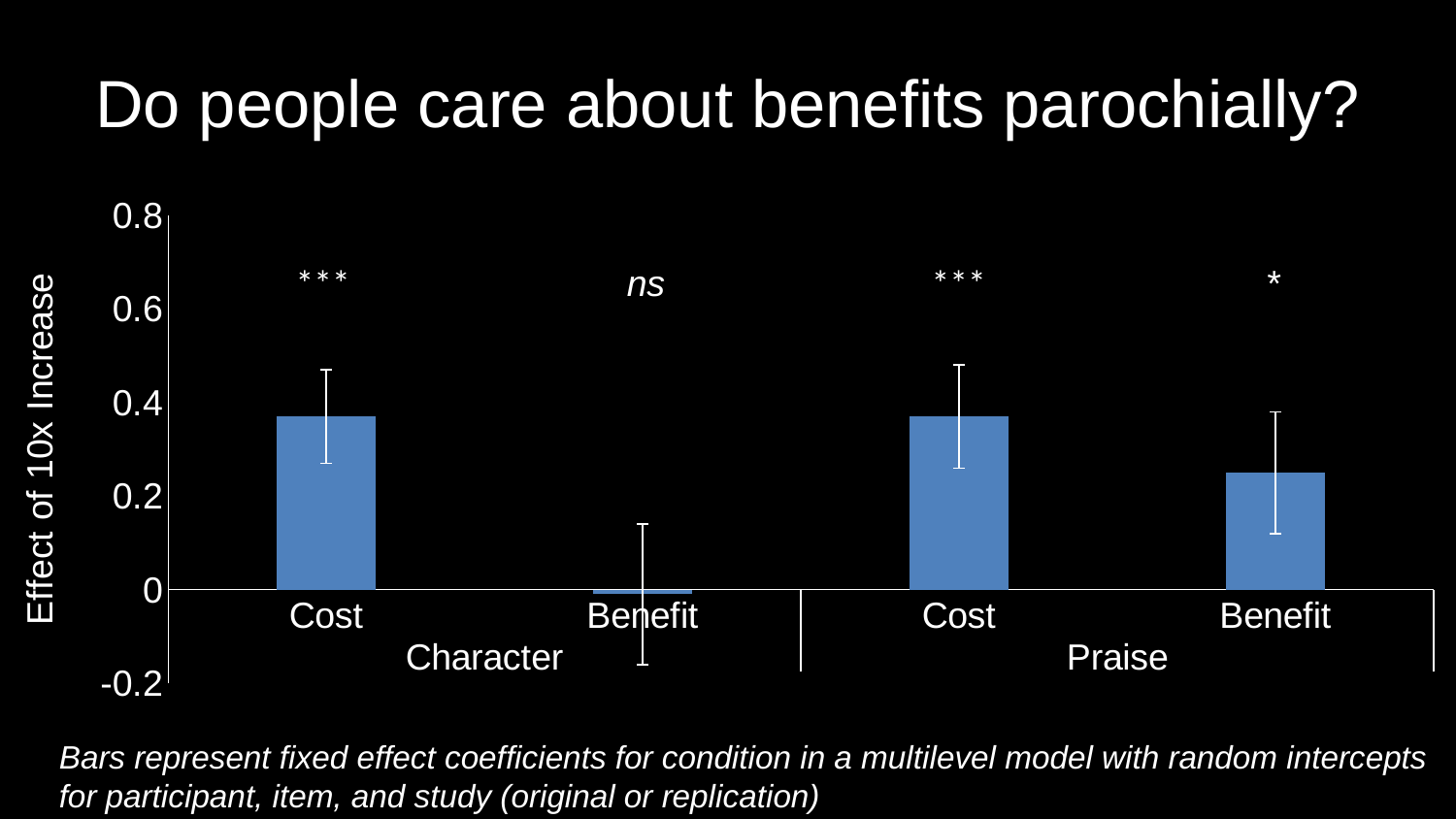
Is the value for Cost in the Character group greater or less than 0.2? greater In the Character group, which bar is larger, Cost or Benefit? Cost Is the value for Cost in the Praise group greater or less than 0.4? less Which bar has the lowest value in the chart? Benefit (Character) Is the value for Benefit in the Character group greater or less than 0.2? less What significance marker is shown above the Benefit bar in the Character group? ns How many bars are plotted in the chart? 4 What is the label on the y axis of the chart? Effect of 10x Increase What kind of chart is shown on the slide? bar chart In the Praise group, which bar is larger, Cost or Benefit? Cost